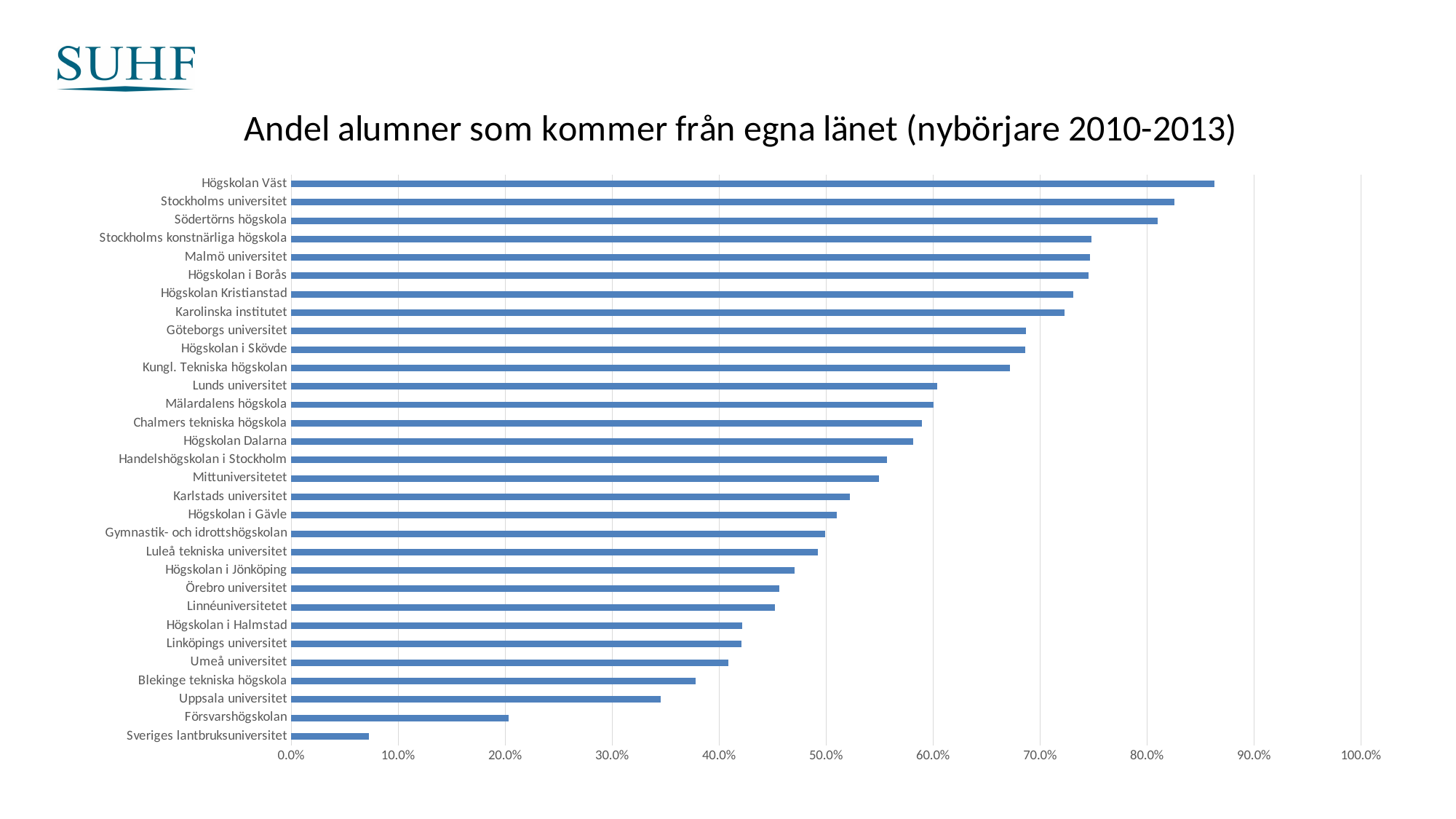
Which has a larger value, Högskolan Väst or Stockholms universitet? Högskolan Väst Which institution has the lowest share of alumni from its own county? Sveriges lantbruksuniversitet Which has a larger value, Blekinge tekniska högskola or Uppsala universitet? Blekinge tekniska högskola Is the value for Högskolan Väst greater or less than 80.0%? greater Is the value for Uppsala universitet greater or less than 40.0%? less Is the value for Karolinska institutet greater or less than 70.0%? greater What kind of chart is shown on the slide? bar chart Which institution has the highest share of alumni from its own county? Högskolan Väst What is the title of the chart? Andel alumner som kommer från egna länet (nybörjare 2010-2013) How many institutions are listed in the chart? 31